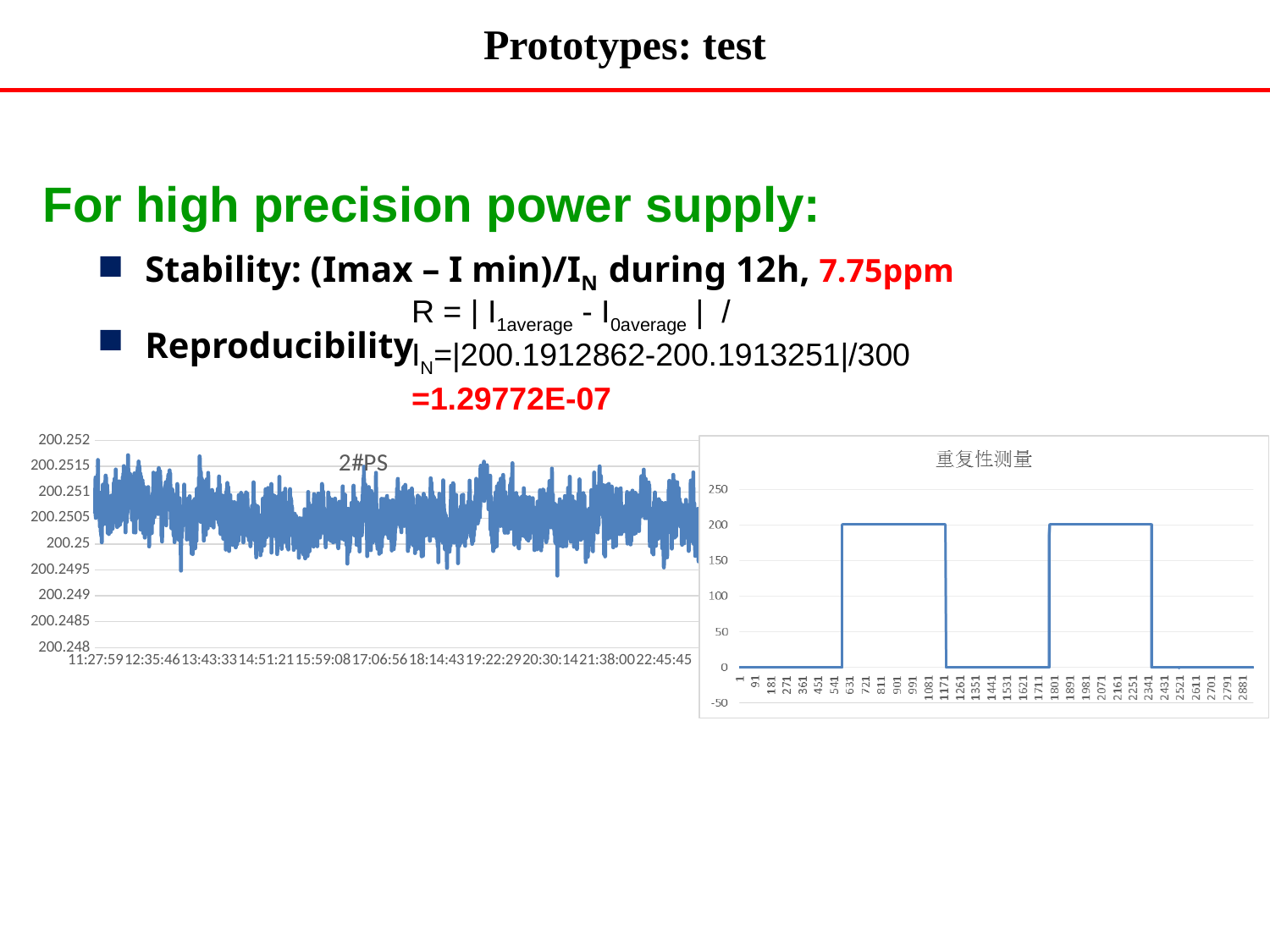
In the left chart (2#PS), what is the first time label on the x axis? 11:27:59 What kind of chart is the right chart titled 重复性测量? line chart In the left chart (2#PS), what is the lowest value shown on the y axis? 200.248 In the right chart (重复性测量), what value does the line reach during the pulses? 200 What is the title of the left chart? 2#PS What is the title of the right chart? 重复性测量 In the right chart (重复性测量), is the value at x = 1 greater or less than 50? less What kind of chart is the left chart titled 2#PS? line chart In the left chart (2#PS), what is the last time label on the x axis? 22:45:45 In the left chart (2#PS), what is the highest value shown on the y axis? 200.252 In the right chart (重复性测量), how many rectangular pulses does the line show? 2